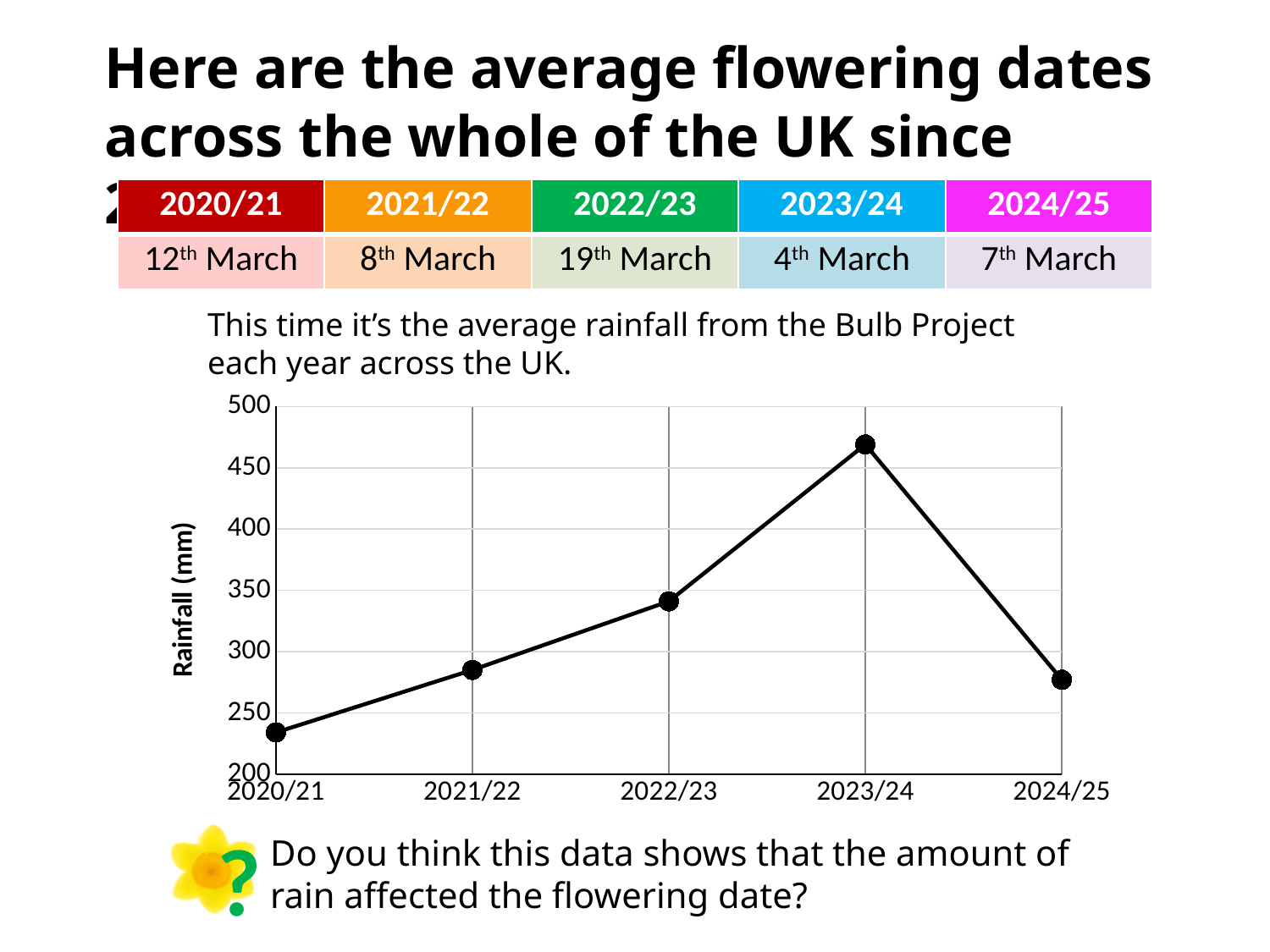
Is the rainfall value for 2024/25 greater or less than 300? less Which year has higher rainfall, 2022/23 or 2021/22? 2022/23 Is the rainfall value for 2020/21 greater or less than 250? less What kind of chart is shown on the slide? line chart Which year has the highest rainfall on the chart? 2023/24 Which year has the lowest rainfall on the chart? 2020/21 Is the rainfall value for 2021/22 greater or less than 250? greater How many data points are plotted on the rainfall chart? 5 Does rainfall rise or fall from 2020/21 to 2023/24? rise What is the label on the vertical axis of the chart? Rainfall (mm)